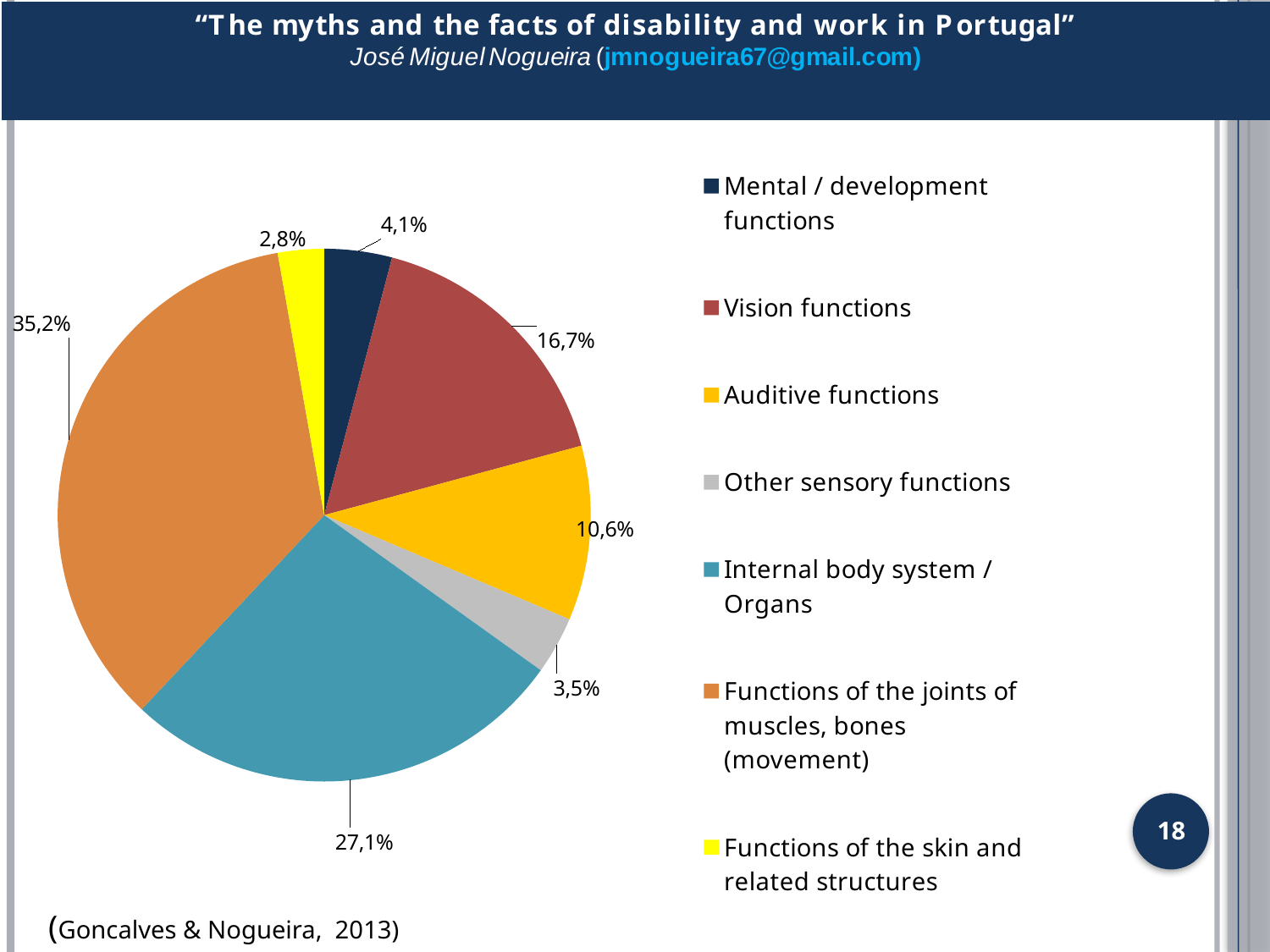
What percentage is shown for Internal body system / Organs? 27,1% What percentage is shown for Auditive functions? 10,6% What colour is the slice for Auditive functions? Yellow-orange Which category has the smallest slice of the pie? Functions of the skin and related structures What percentage is shown for Functions of the skin and related structures? 2,8% Which is larger: the slice for Mental / development functions or the slice for Other sensory functions? Mental / development functions What is the difference in percentage points between Functions of the joints of muscles, bones (movement) and Internal body system / Organs? 8,1 What share of the pie is labelled for Vision functions? 16,7% How many entries does the legend list? 7 Which category has the largest slice of the pie? Functions of the joints of muscles, bones (movement) How many slices does the pie chart have? 7 What kind of chart is shown on the slide? Pie chart